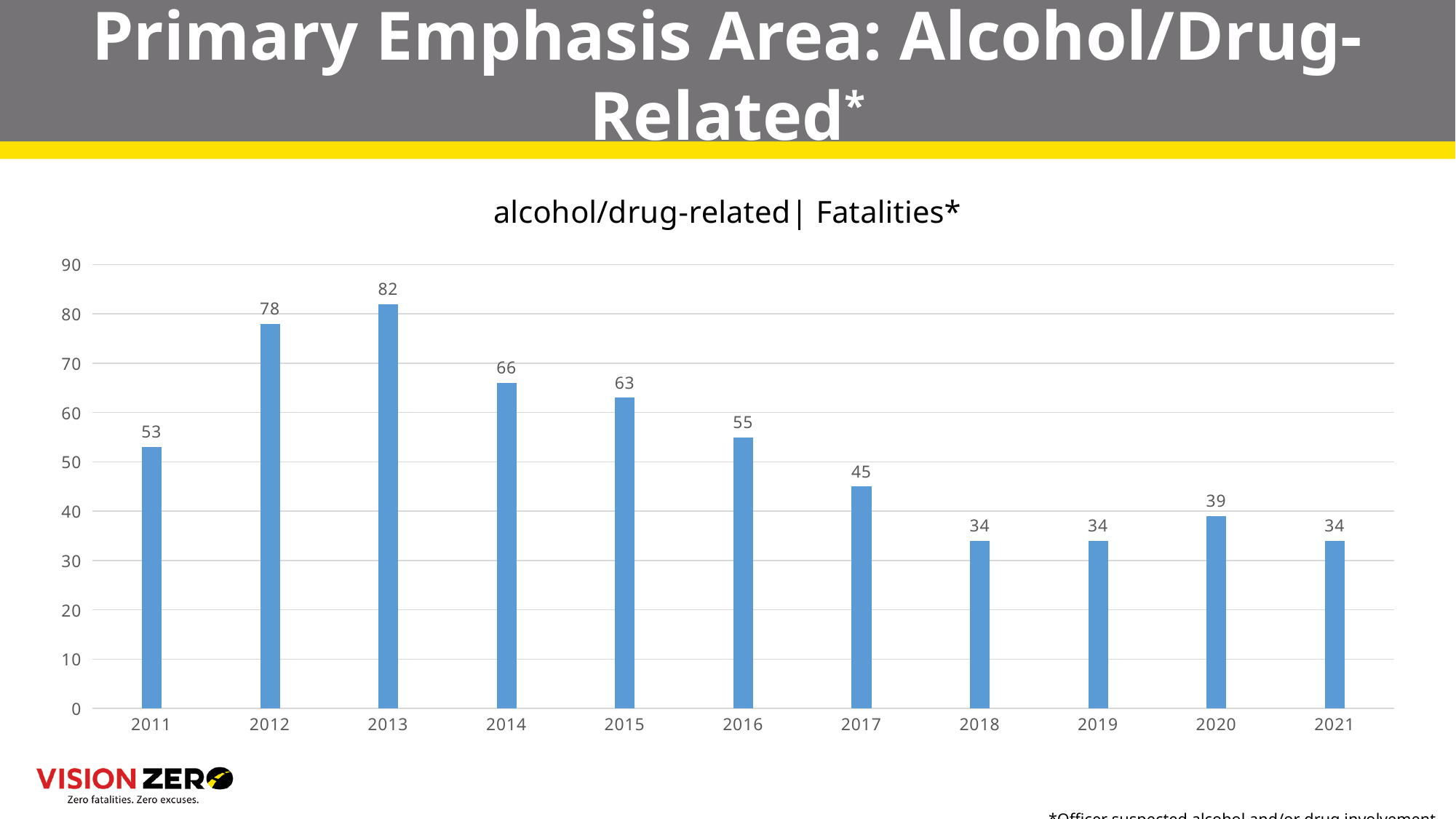
What is the value for 2013? 82 Is the value for 2015 greater or less than 60? greater Which is larger, the value for 2014 or the value for 2016? 2014 Which year has the highest value? 2013 What is the difference between the values for 2012 and 2011? 25 What is the title of the chart? alcohol/drug-related| Fatalities* What is the value for 2017? 45 What kind of chart is shown on the slide? bar chart How many years are shown on the x axis? 11 What is the value for 2020? 39 What is the difference between the values for 2013 and 2021? 48 Do the values generally rise or fall from 2013 to 2019? fall